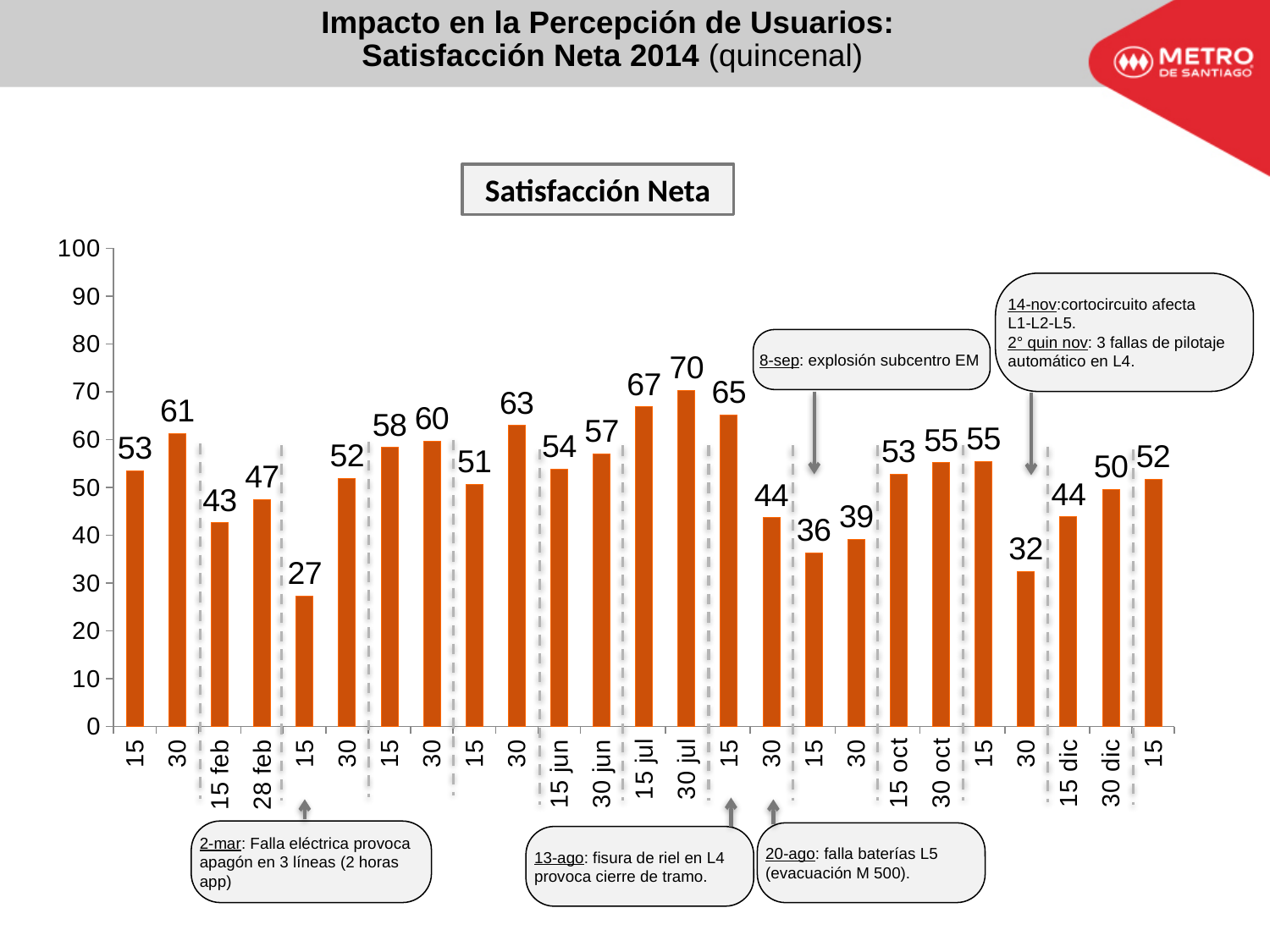
What is the Satisfacción Neta value for 15 dic? 44 What is the difference between the values for 30 jul and 15 jul? 3 What is the Satisfacción Neta value for 30 jul? 70 What is the Satisfacción Neta value for 15 feb? 43 Is the value for 28 feb greater or less than 50? less What kind of chart is shown on the slide? bar chart Which has a higher value, 15 oct or 30 oct? 30 oct What is the difference between the values for 30 jun and 15 jun? 3 How many bars are plotted on the chart? 25 What is the lowest Satisfacción Neta value shown on the chart? 27 What is the Satisfacción Neta value for 30 dic? 50 Which period has the highest Satisfacción Neta value? 30 jul